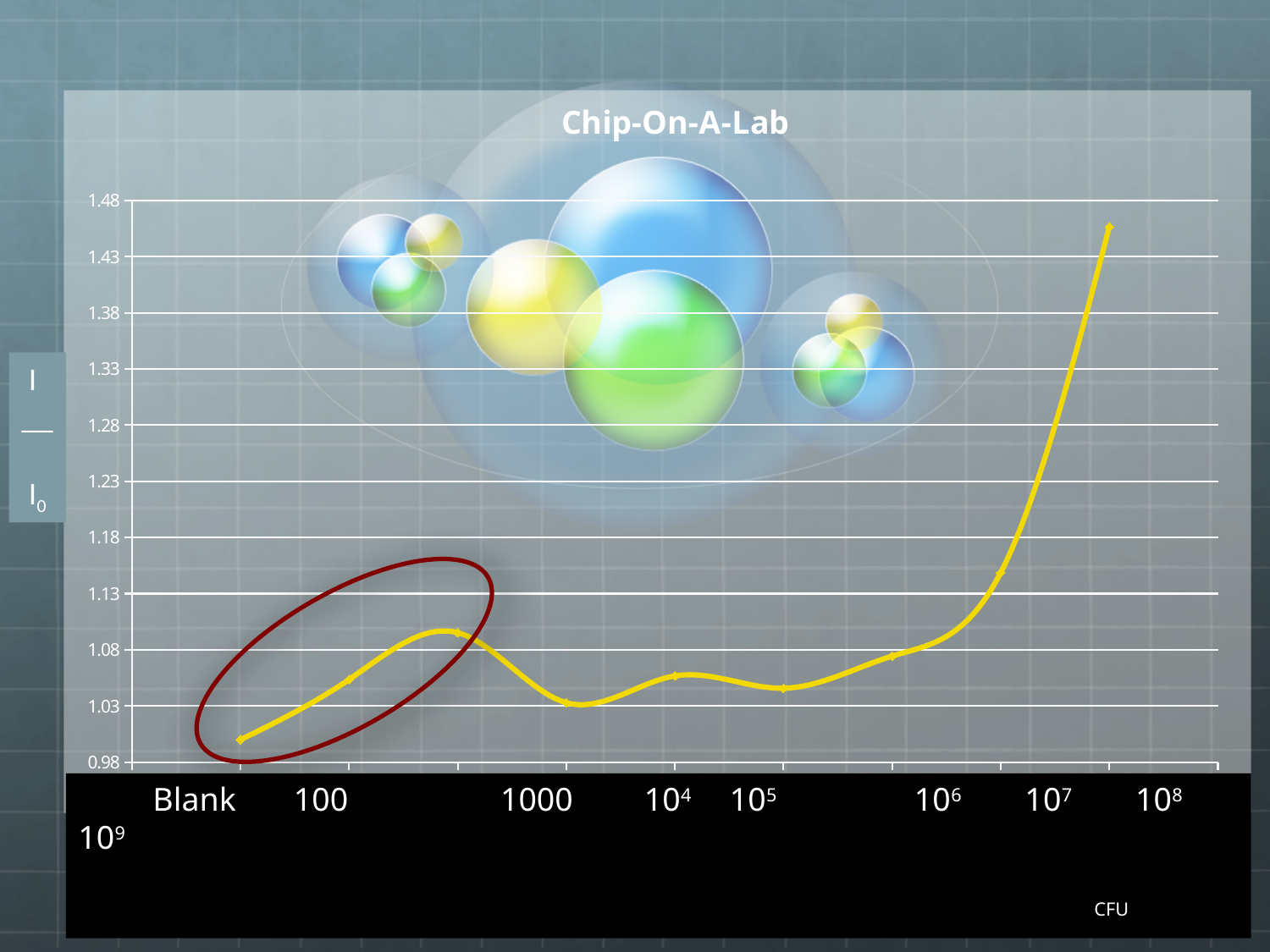
Is the value of the rightmost point on the line greater or less than 1.43? greater Which point on the line has the highest value, the leftmost or the rightmost? the rightmost What is the lowest value shown on the y axis? 0.98 What is the title of the chart? Chip-On-A-Lab Is the value of the rightmost point on the line greater or less than 1.48? less How many data points are plotted on the line? 9 Which point on the line has the lowest value? Blank What kind of chart is shown on the slide? line chart What is the label shown on the x axis of the chart? CFU Does the line overall rise or fall from left to right across the x axis? rise Is the value for Blank greater or less than 1.03? less Is the value for Blank larger or smaller than the value of the rightmost point? smaller